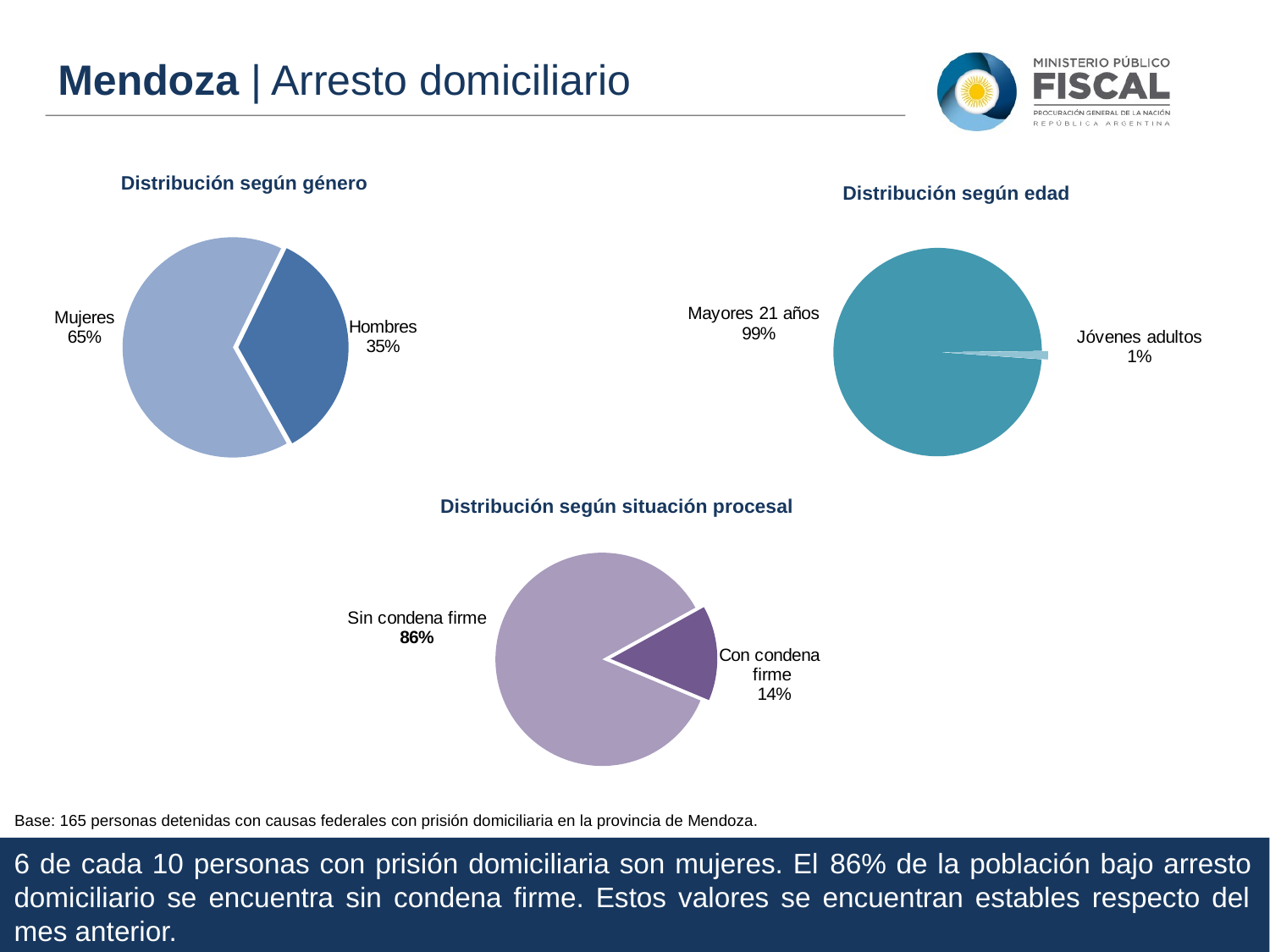
In the 'Distribución según género' chart, what is the difference in percentage points between Mujeres and Hombres? 30 What kind of chart is 'Distribución según situación procesal'? Pie chart How many charts are shown on the slide? 3 In the 'Distribución según situación procesal' chart, what share is Con condena firme? 14% In the 'Distribución según edad' chart, what share is Jóvenes adultos? 1% In the 'Distribución según situación procesal' chart, which is larger, Sin condena firme or Con condena firme? Sin condena firme In the 'Distribución según género' chart, what share is Mujeres? 65% In the 'Distribución según edad' chart, which category has the smallest slice? Jóvenes adultos In the 'Distribución según género' chart, which category has the largest slice? Mujeres In the 'Distribución según edad' chart, what share is Mayores 21 años? 99% In the 'Distribución según género' chart, what share is Hombres? 35% In the 'Distribución según situación procesal' chart, what share is Sin condena firme? 86%